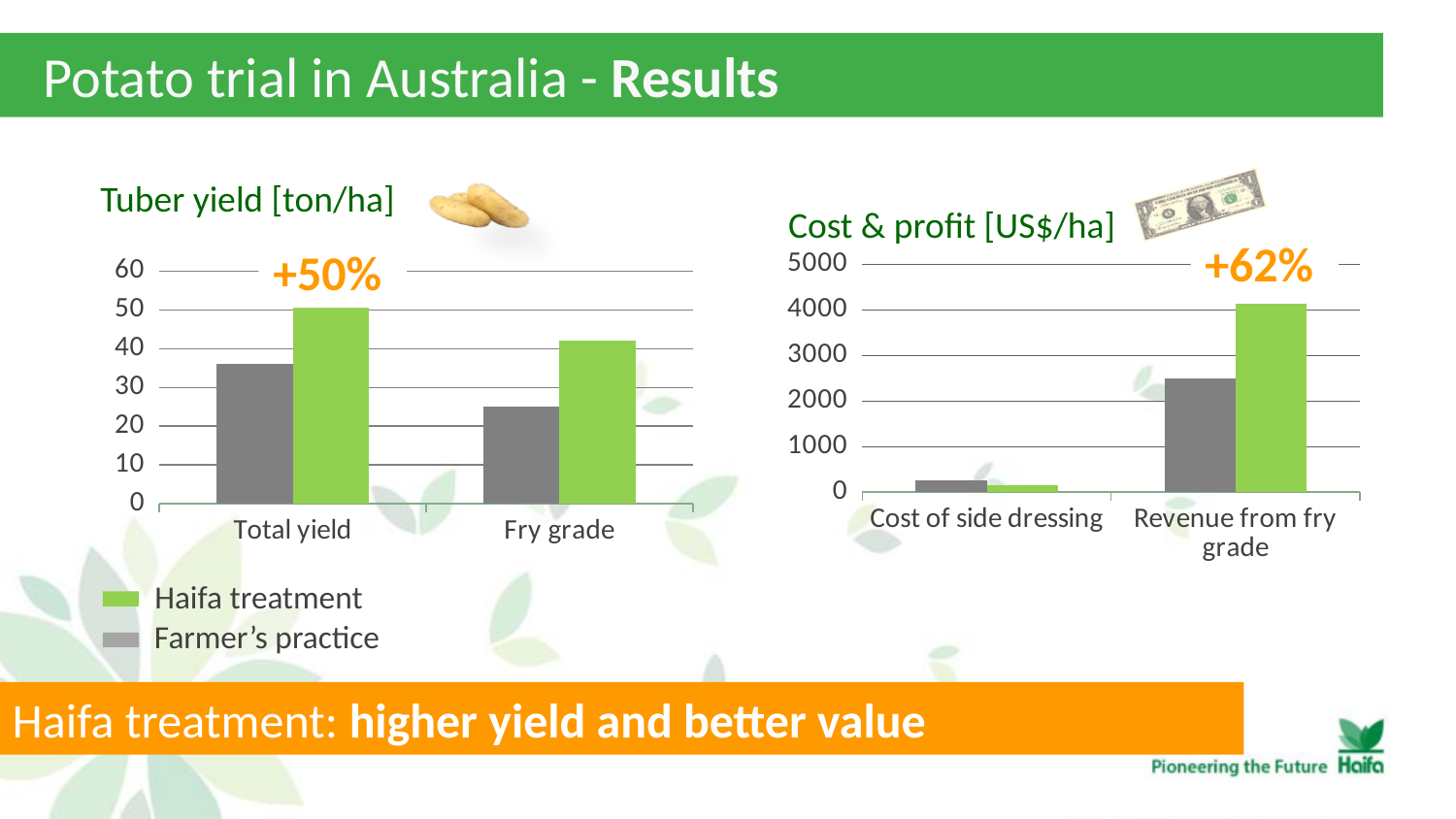
What percentage annotation is printed above the bars in the "Cost & profit [US$/ha]" chart? +62% How many categories are shown on the x axis of the "Tuber yield [ton/ha]" chart? 2 In the "Tuber yield [ton/ha]" chart, is the Farmer's practice value for Fry grade greater or less than 30? less How many categories are shown on the x axis of the "Cost & profit [US$/ha]" chart? 2 In the "Cost & profit [US$/ha]" chart, is the Farmer's practice value for Revenue from fry grade greater or less than 3000? less In the "Tuber yield [ton/ha]" chart, which series has the larger Total yield value, Haifa treatment or Farmer's practice? Haifa treatment In the "Cost & profit [US$/ha]" chart, which category has the highest Haifa treatment value? Revenue from fry grade How many series does the legend list for the charts on the slide? 2 In the "Tuber yield [ton/ha]" chart, is the Farmer's practice value for Total yield greater or less than 30? greater What kind of chart is the "Tuber yield [ton/ha]" chart? bar chart